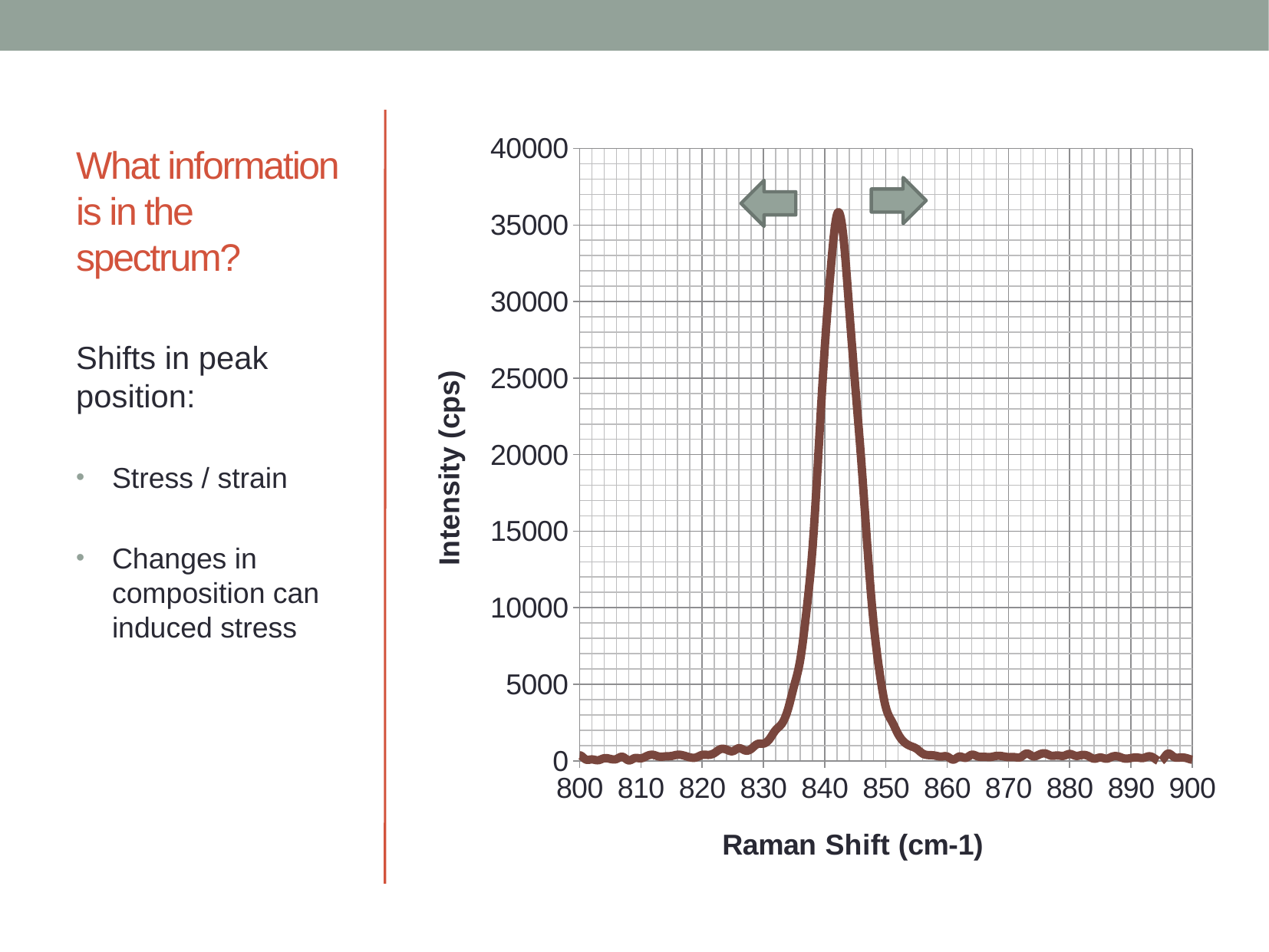
Which has the higher intensity: the Raman shift of 840 or 860? 840 Does the intensity rise or fall as the Raman shift goes from 850 to 900? fall What is the highest value shown on the y axis? 40000 Does the intensity rise or fall as the Raman shift goes from 820 to 840? rise What is the label of the x axis? Raman Shift (cm-1) Is the intensity at a Raman shift of 870 greater or less than 5000? less Is the intensity at a Raman shift of 800 greater or less than 5000? less What kind of chart is shown on the slide? line chart Is the intensity at a Raman shift of 840 greater or less than 10000? greater Between which two x-axis tick values does the peak of the spectrum lie? 840 and 850 What is the label of the y axis? Intensity (cps)